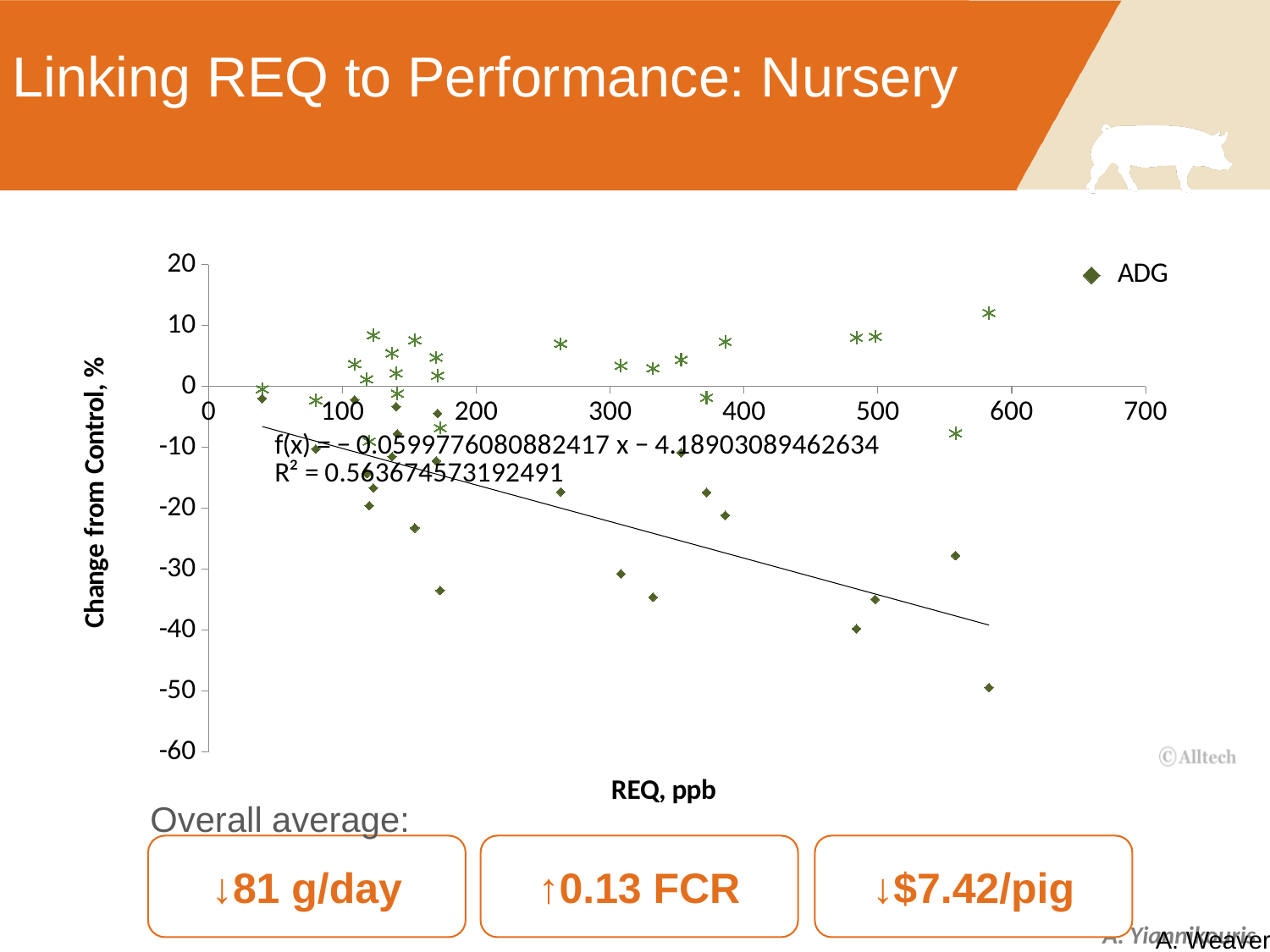
What kind of chart is shown on the slide? scatter chart Is the lowest ADG point on the chart (near 590 ppb) greater or less than -40? less What is the maximum value shown on the y axis of the chart? 20 How many series does the chart's legend list? 1 What is the label of the x axis of the chart? REQ, ppb What series name appears in the chart's legend? ADG What R² value is printed on the chart for the trendline? 0.563674573192491 Is the highest asterisk point on the chart (near 585 ppb) greater or less than 10? greater What is the maximum value shown on the x axis of the chart? 700 Do the ADG values generally rise or fall as REQ increases along the x axis? fall Is the ADG point near 500 ppb greater or less than -30? less